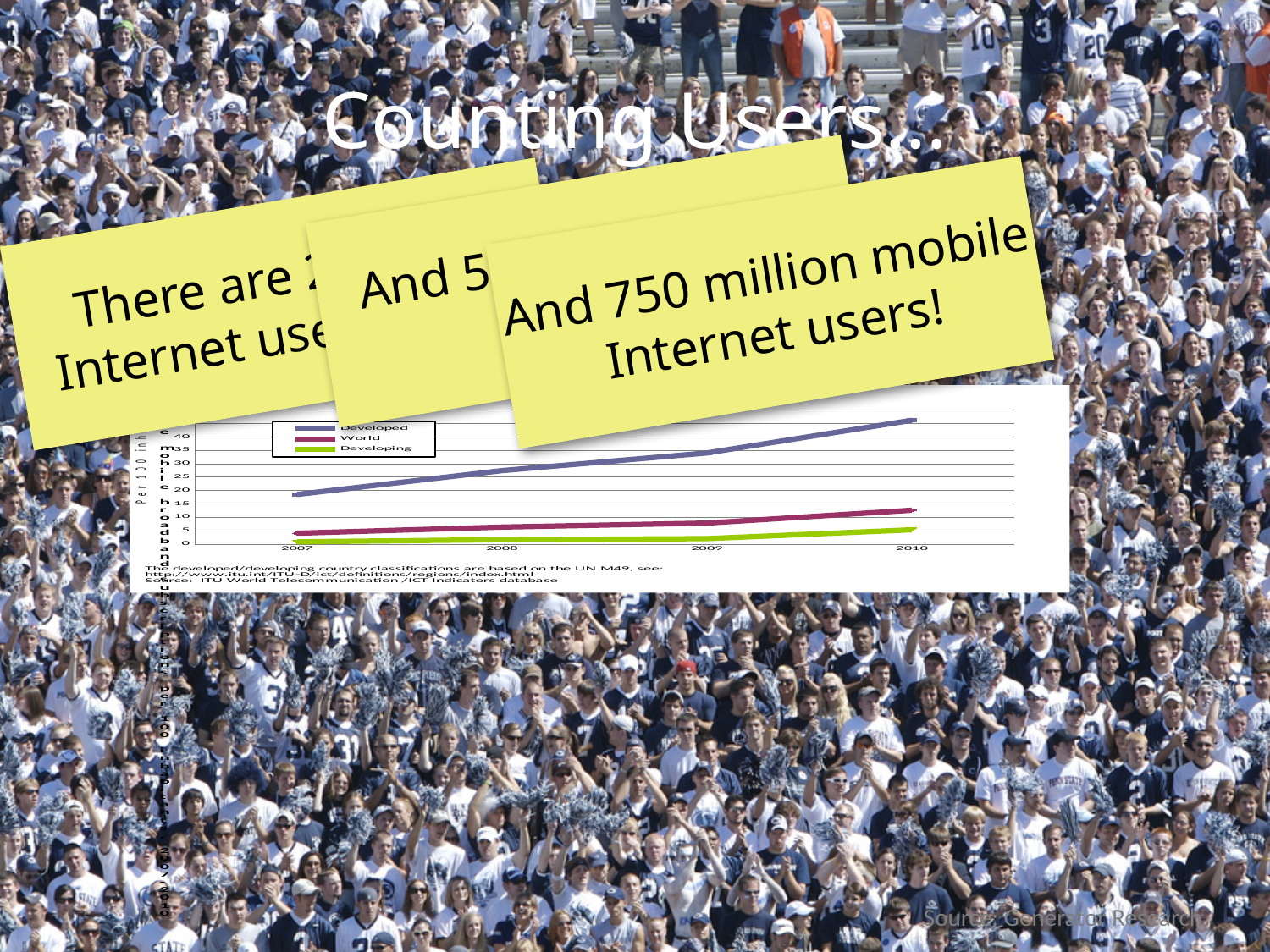
Does the Developed series rise or fall from 2007 to 2010? rise How many series does the chart's legend list? 3 What colour is the Developing line in the chart? green Which series are listed in the chart's legend? Developed, World, Developing What kind of chart is shown on the slide? line chart Is the value for World in 2010 greater or less than 15? less In 2009, which is larger: the value for World or the value for Developing? World How many years are shown along the x axis of the chart? 4 Is the value for Developed in 2010 greater or less than 40? greater Which series has the lowest values across the chart? Developing Which series has the highest values across the chart? Developed Is the value for Developing in 2010 greater or less than 10? less